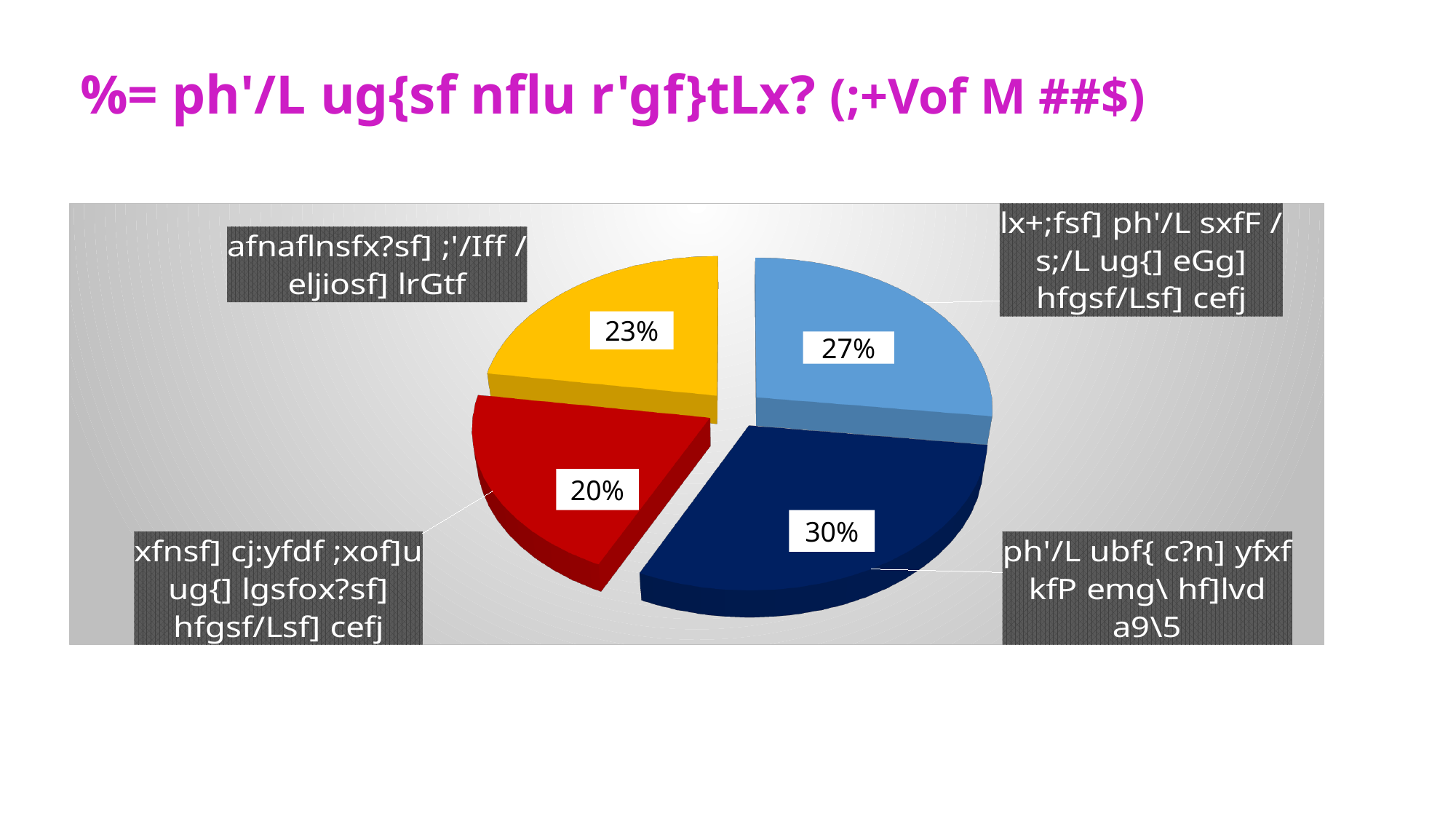
What is the difference between the dark blue slice and the red slice of the pie chart? 10% What percentage is shown on the yellow slice of the pie chart? 23% What percentage is shown on the red slice of the pie chart? 20% What percentage is shown on the light blue slice of the pie chart? 27% What is the difference between the light blue slice and the yellow slice of the pie chart? 4% Which slice of the pie chart has the largest share? the dark blue slice (30%) Which is larger in the pie chart, the light blue slice or the yellow slice? the light blue slice What percentage is shown on the dark blue slice of the pie chart? 30% Which slice of the pie chart has the smallest share? the red slice (20%) How many slices does the pie chart have? 4 What kind of chart is shown on the slide? pie chart What colour is the slice labelled 23% in the pie chart? yellow